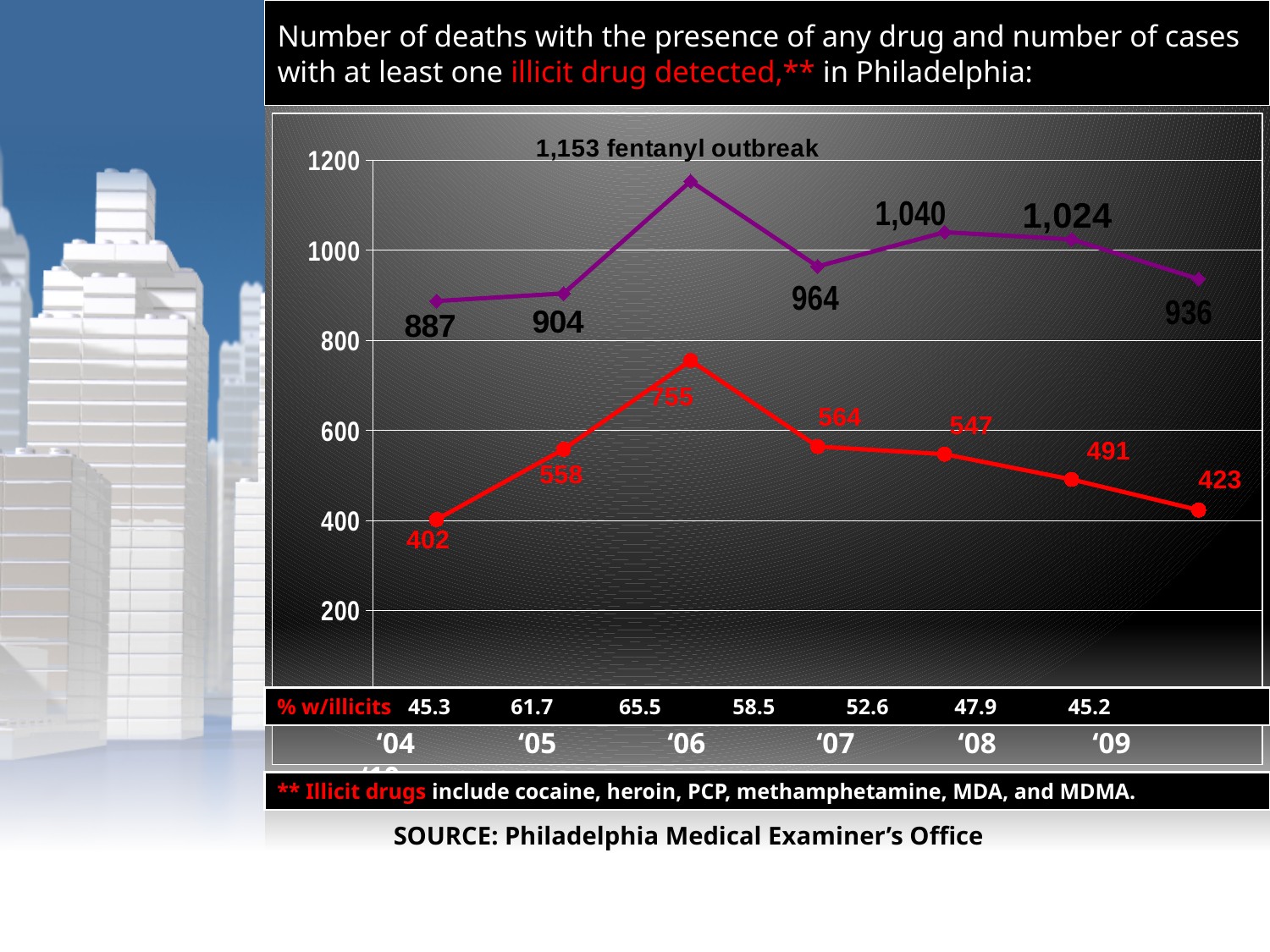
Does the red line rise or fall from '06 to '09? Fall What is the value of the red line (cases with at least one illicit drug detected) for '06? 755 In which year does the purple line (deaths with any drug) reach its highest value? '06 How many data points are plotted on each line? 7 What type of chart is shown on the slide? Line chart What annotation is written next to the peak of the purple line? 1,153 fentanyl outbreak What is the value of the purple line (deaths with the presence of any drug) for '04? 887 What is the difference between the purple line value and the red line value in '06? 398 What is the '% w/illicits' value shown for '06? 65.5 By how much did the red line (illicit drug cases) increase from '04 to '05? 156 Which year has the higher value on the purple line, '08 or '09? '08 In which year is the red line (illicit drug cases) at its lowest value? '04